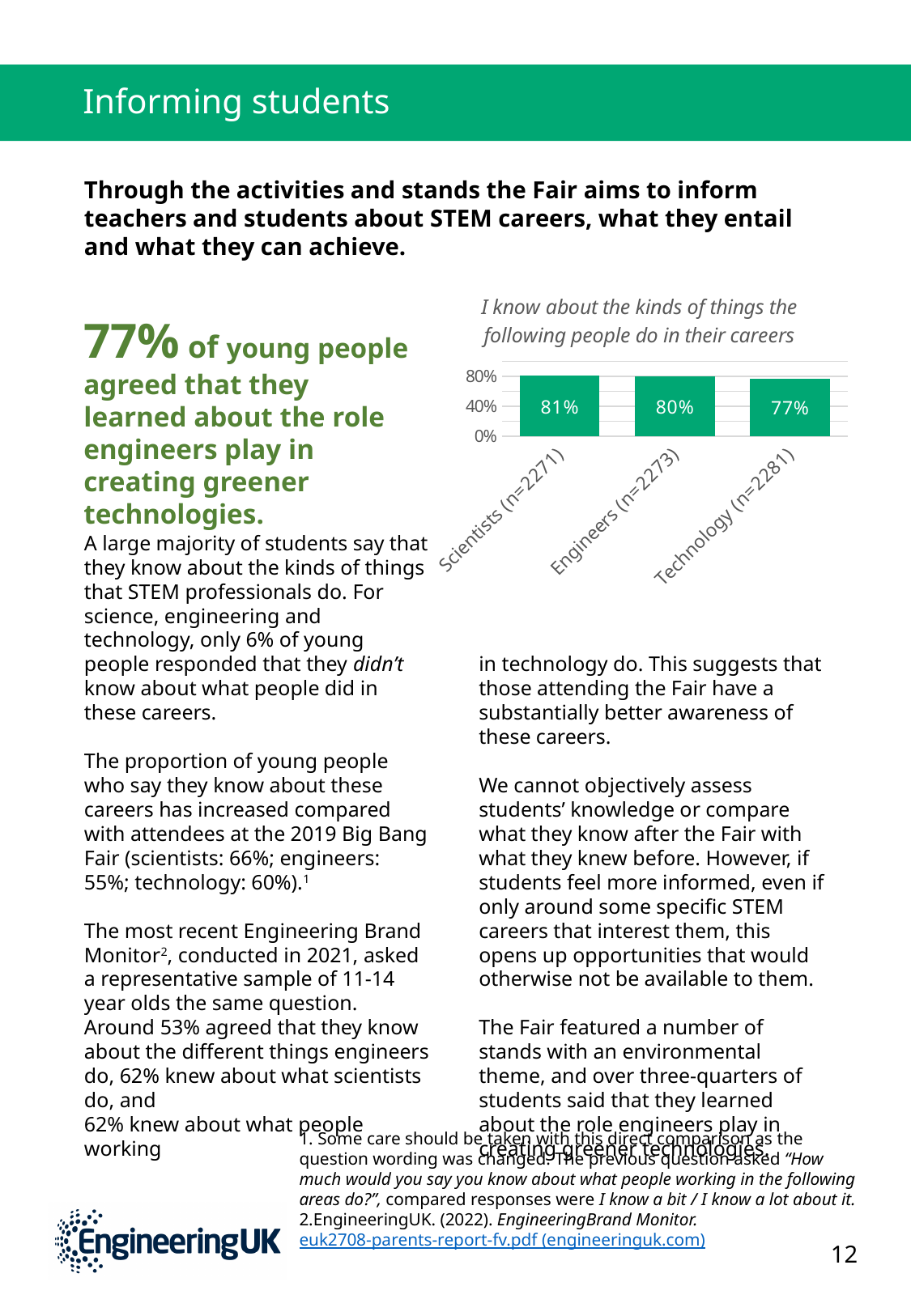
Which category has the highest value in the chart? Scientists (n=2271) What is the value shown for Engineers (n=2273) in the chart? 80% What percentage of respondents agreed they know about the kinds of things scientists do in their careers? 81% What is the title of the chart? I know about the kinds of things the following people do in their careers What is the value shown for Technology (n=2281) in the chart? 77% What is the difference between the values for Scientists and Technology? 4% Do the values rise or fall from left to right across the chart? Fall What is the difference between the values for Engineers and Technology? 3% Is the value for Scientists greater or less than 40%? greater How many categories are shown in the chart? 3 Which category has the lowest value in the chart? Technology (n=2281) What kind of chart is shown on the slide? Bar chart